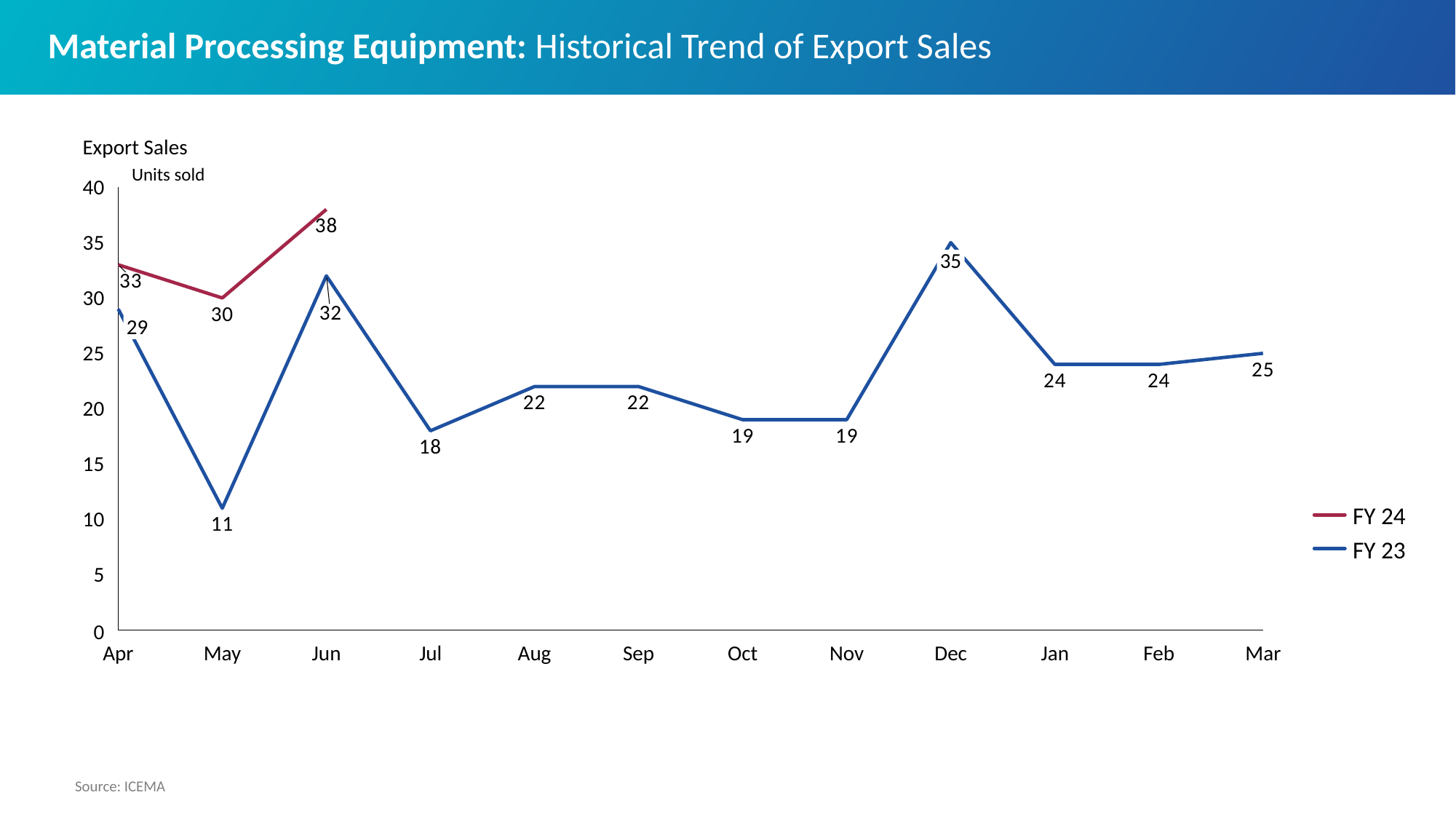
Does the FY 24 line rise or fall from May to Jun? Rise What kind of chart is shown on the slide? Line chart What is the FY 23 value for May? 11 Which is larger, the FY 24 value for Apr or the FY 23 value for Apr? FY 24 What is the unit shown on the y axis? Units sold What is the difference between the FY 24 and FY 23 values for May? 19 How many series does the legend list? 2 Which month has the highest FY 23 value? Dec Which month has the lowest FY 23 value? May How many months are shown on the x axis? 12 What is the FY 23 value for Dec? 35 What is the FY 24 value for Jun? 38